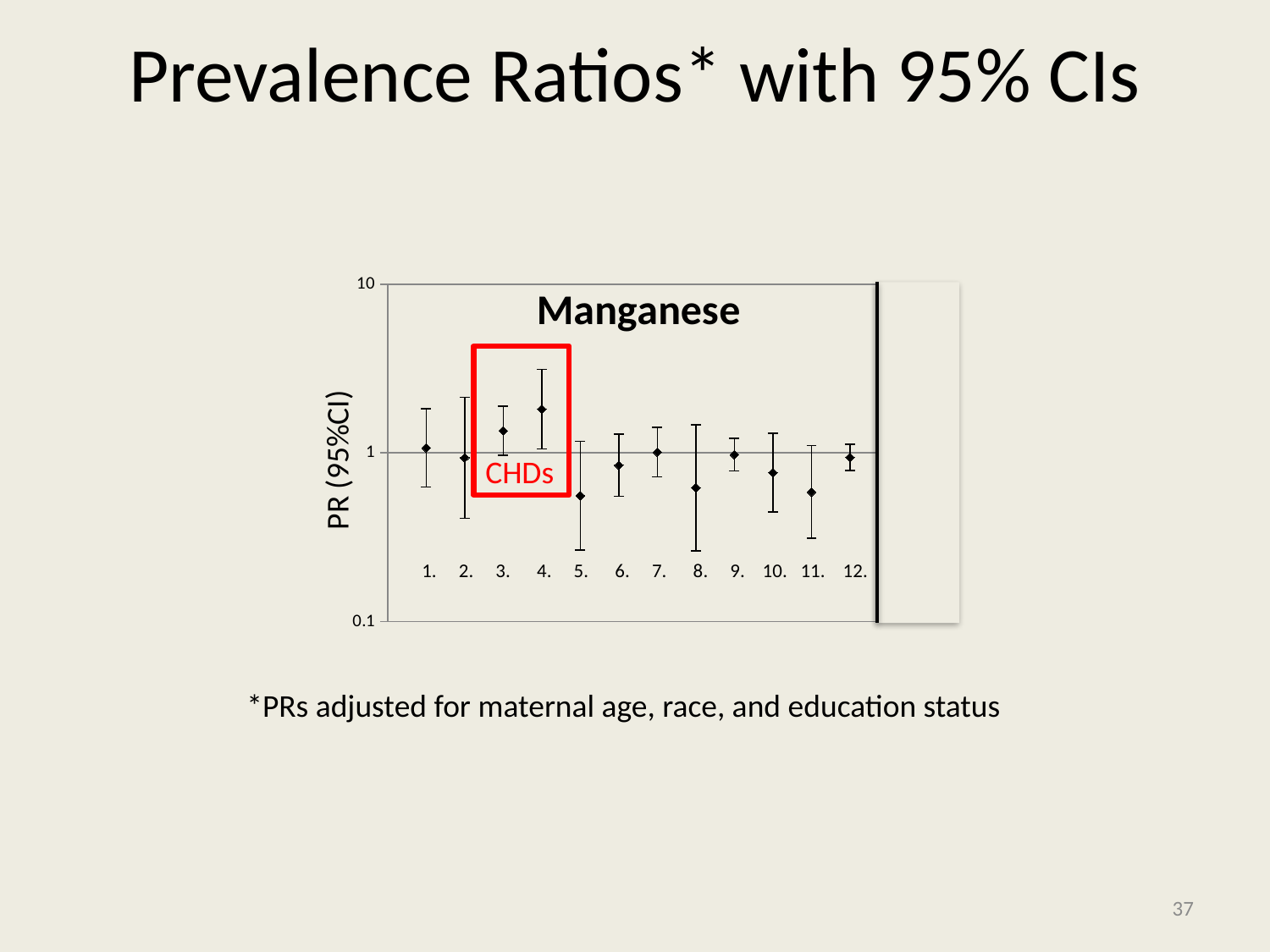
Is the prevalence ratio for category 8 greater or less than 1? less What kind of chart is this? Scatter (point) chart with error bars Which has the larger prevalence ratio, category 4 or category 5? 4. Is the prevalence ratio for category 11 greater or less than 1? less Which has the larger prevalence ratio, category 3 or category 10? 3. How many numbered categories are plotted along the x axis? 12 Which numbered category has the highest plotted prevalence ratio? 4. What is the title shown inside the chart? Manganese Is the prevalence ratio for category 3 greater or less than 1? greater What is the label on the vertical axis of the chart? PR (95%CI)